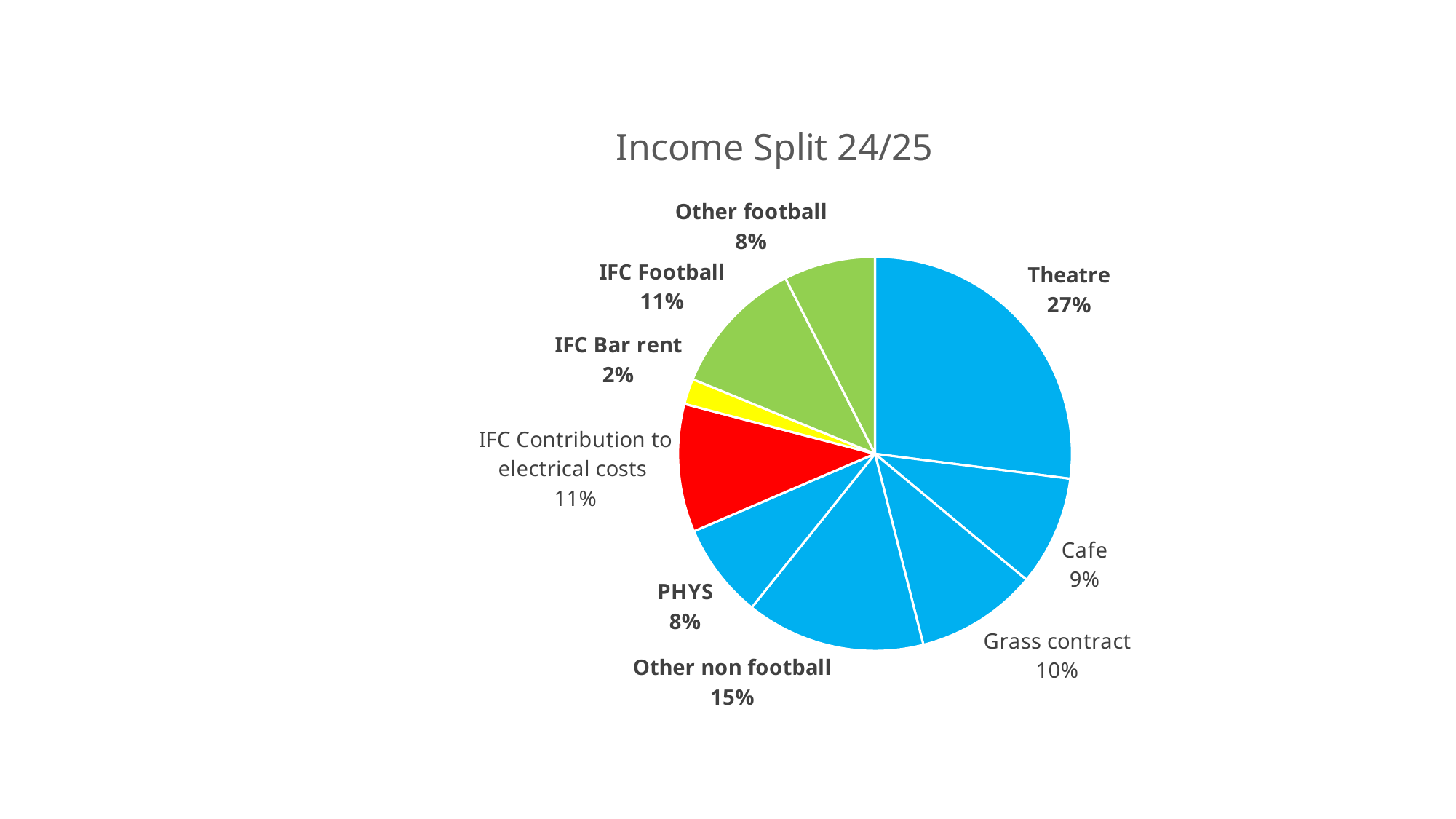
What colour is the IFC Contribution to electrical costs slice? Red Which category has the smallest slice of the pie? IFC Bar rent What is the difference in percentage points between Theatre and Other non football? 12 What percentage is shown for IFC Bar rent? 2% Which is larger, Cafe or Grass contract? Grass contract How many categories are shown in the pie chart? 9 What percentage is shown for Grass contract? 10% Which category has the largest slice of the pie? Theatre What is the title of the chart? Income Split 24/25 What kind of chart is shown on the slide? Pie chart What share of income does Theatre account for in the Income Split 24/25 pie chart? 27% What percentage is shown for IFC Football? 11%